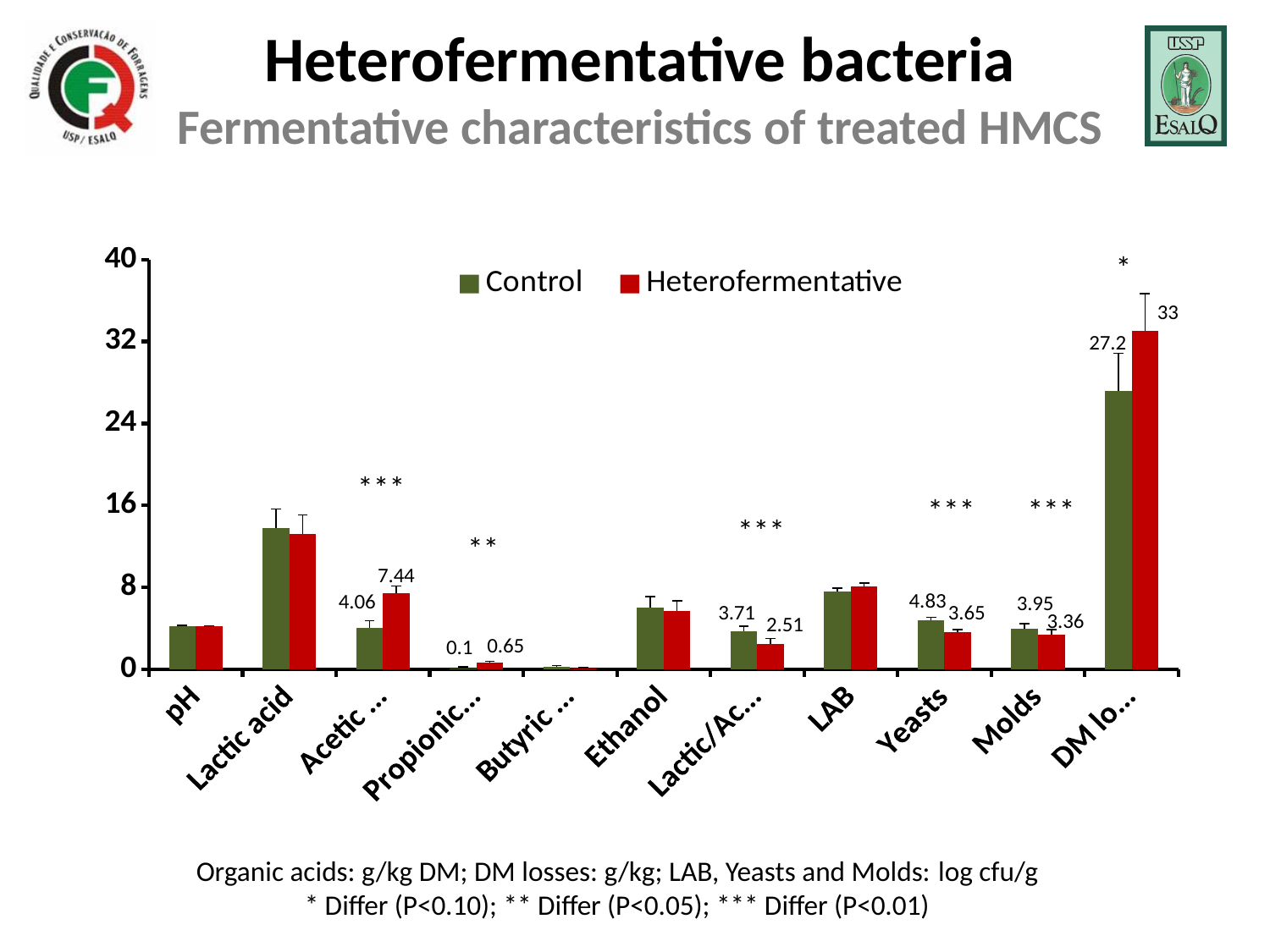
What is the Control value for Yeasts? 4.83 How many series does the legend list? 2 Is the Control value for Lactic acid greater or less than 8? greater Which colour represents the Heterofermentative series in the legend? red What type of chart is shown on the slide? bar chart How many categories are shown along the x axis? 11 What is the Heterofermentative value for the rightmost category (DM lo...)? 33 What is the Heterofermentative value for Molds? 3.36 For Molds, which series has the larger value, Control or Heterofermentative? Control What is the difference between the Heterofermentative and Control values for the rightmost category (DM lo...)? 5.8 What is the difference between the Control and Heterofermentative values for Yeasts? 1.18 What is the Control value for Molds? 3.95